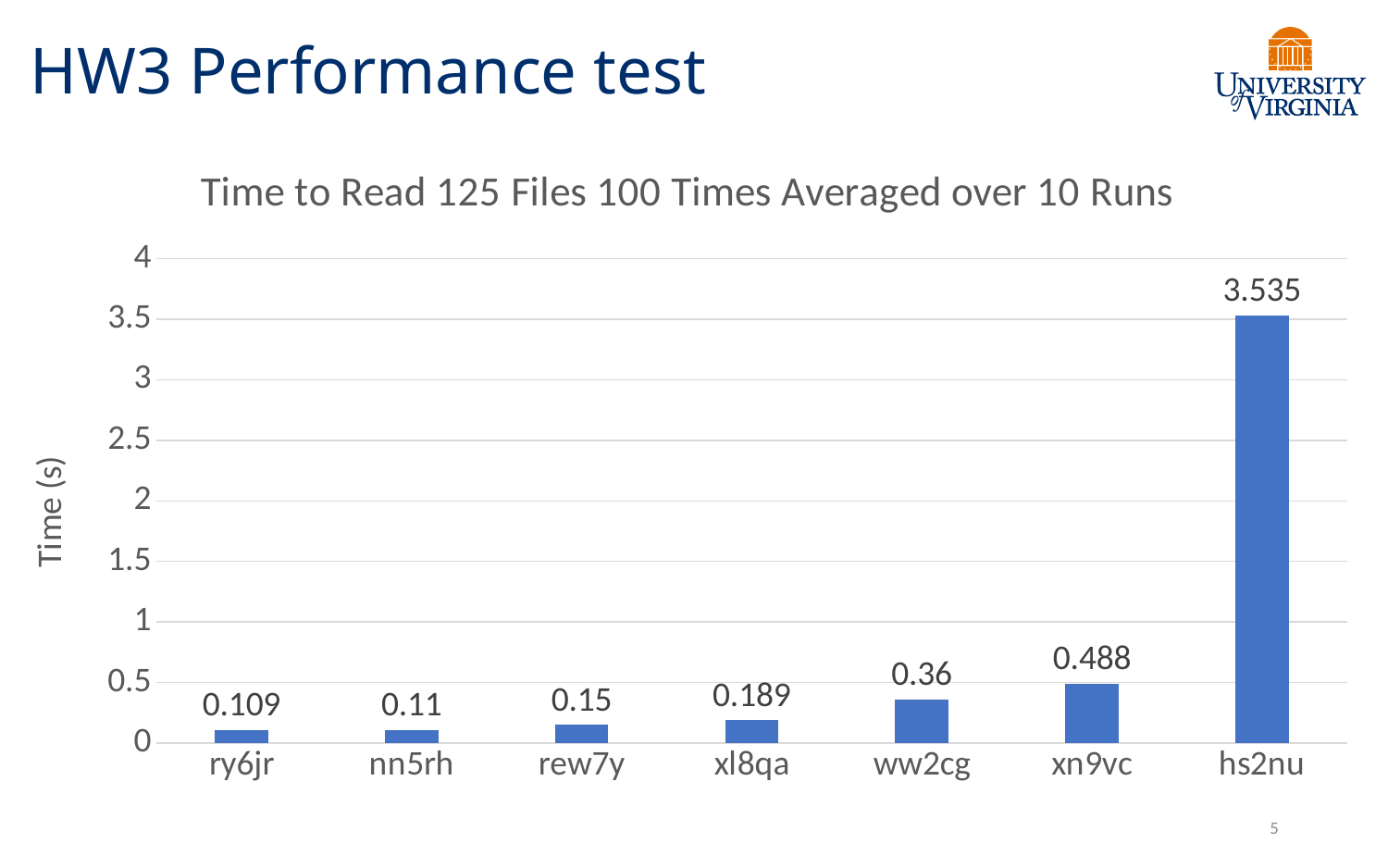
How many categories are shown on the x axis? 7 What is the value for xl8qa? 0.189 Which is larger, the value for rew7y or the value for xl8qa? xl8qa What is the value for hs2nu? 3.535 What kind of chart is shown on the slide? bar chart What is the title of the chart? Time to Read 125 Files 100 Times Averaged over 10 Runs Which category has the highest value? hs2nu What is the difference between the values for xn9vc and ww2cg? 0.128 What is the value for ww2cg? 0.36 Which category has the lowest value? ry6jr Is the value for hs2nu greater or less than 3? greater What is the difference between the values for hs2nu and xn9vc? 3.047